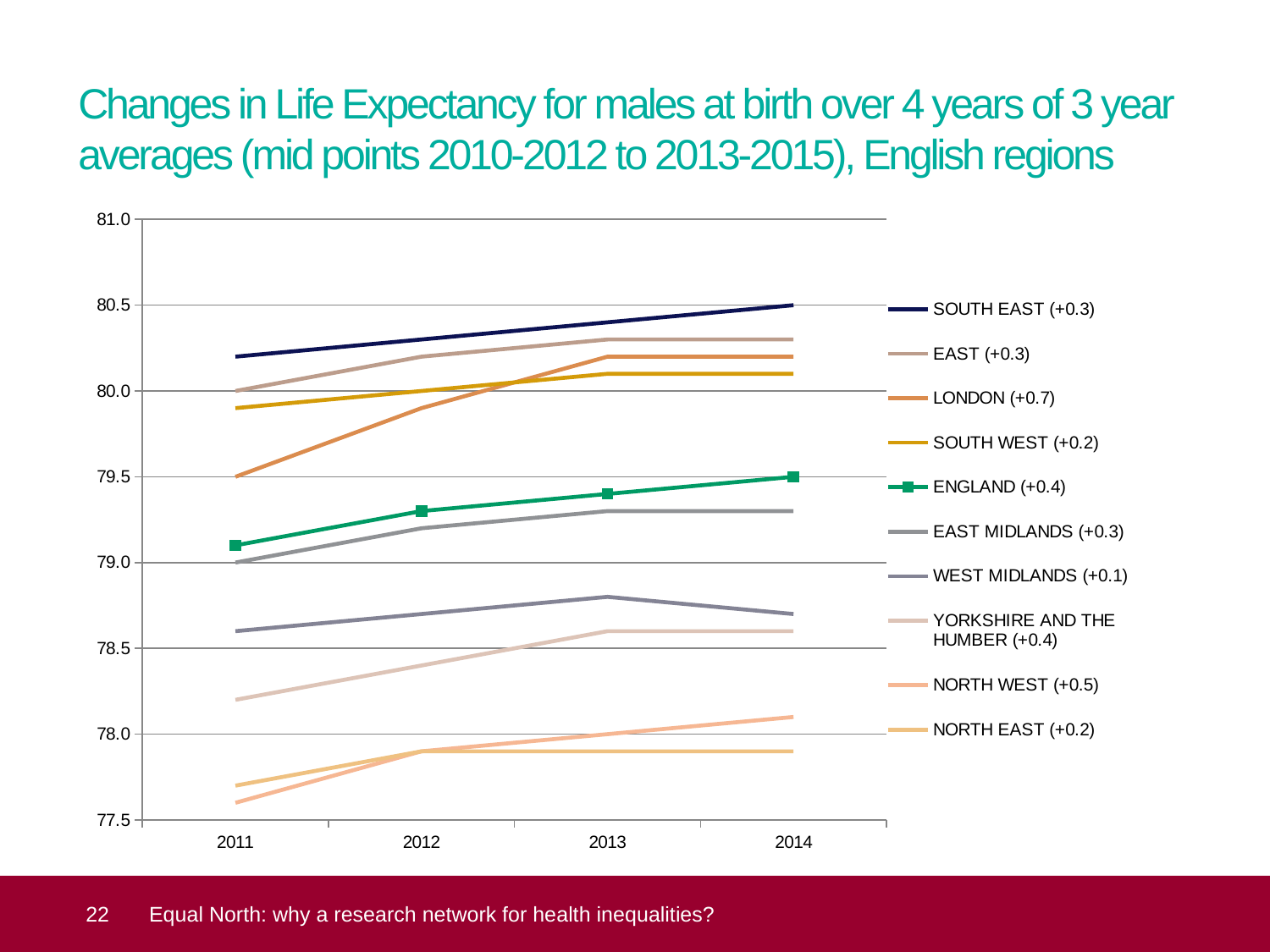
In 2014, which is higher: ENGLAND or EAST MIDLANDS? ENGLAND What kind of chart is shown on the slide? line chart What change does the legend show for WEST MIDLANDS? +0.1 Which region has the highest male life expectancy in 2014? SOUTH EAST Does the LONDON line rise or fall from 2011 to 2014? rise Which region has the lowest male life expectancy in 2014? NORTH EAST Is the value for LONDON in 2014 greater or less than 80.0? greater According to the legend, which region had the largest change in life expectancy? LONDON (+0.7) How many years are shown along the x axis? 4 Is the value for SOUTH EAST in 2011 greater or less than 80.0? greater How many series does the legend list? 10 Is the value for WEST MIDLANDS in 2013 greater or less than 79.0? less